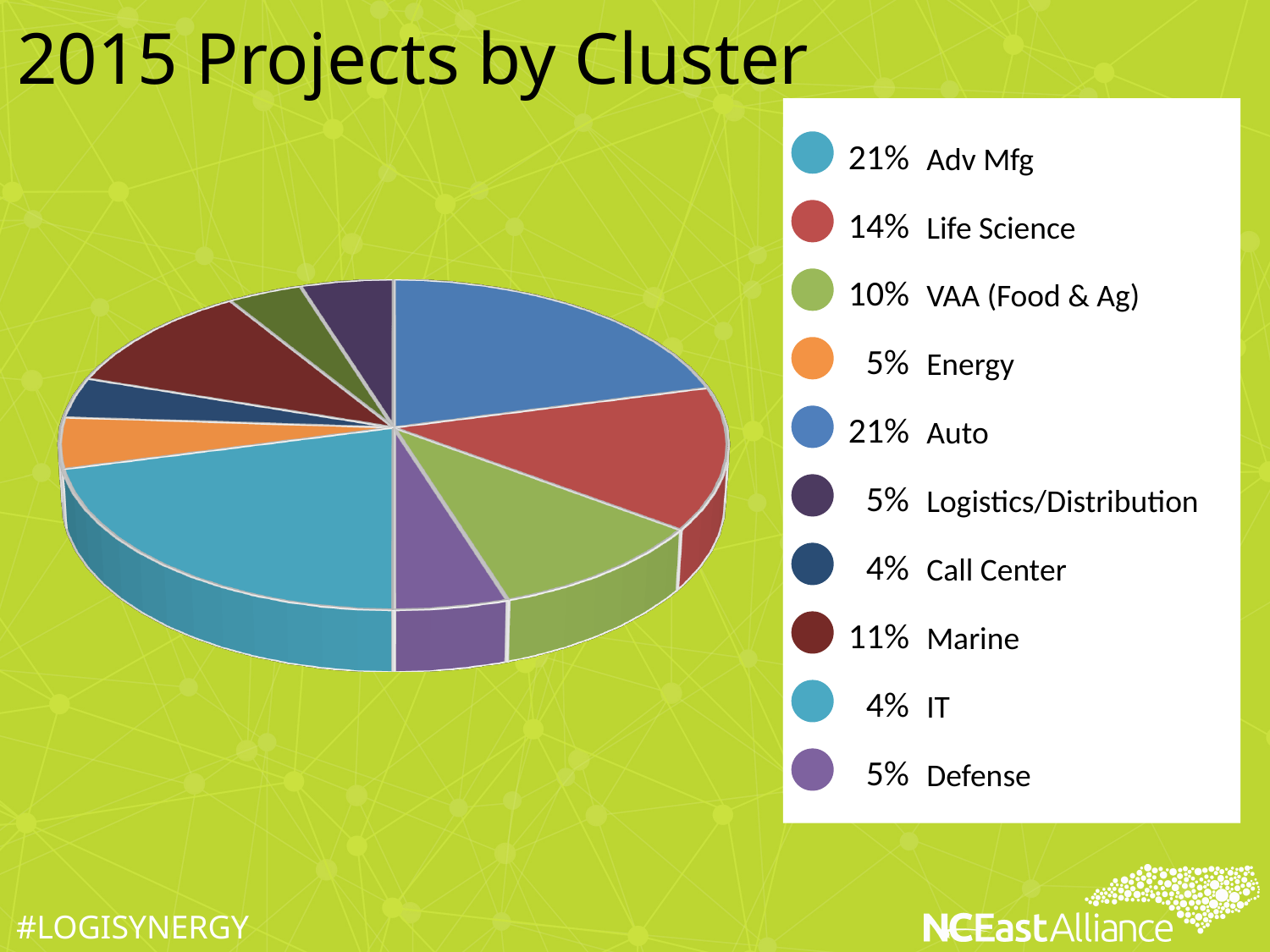
How many clusters are listed in the legend? 10 What share of the pie does Life Science hold? 14% What percentage is shown for Marine? 11% Which is larger, the share for Auto or the share for VAA (Food & Ag)? Auto What kind of chart is shown on the slide? Pie chart What percentage is shown for VAA (Food & Ag)? 10% What is the difference in percentage points between Adv Mfg and Life Science? 7 What is the difference in percentage points between Marine and Energy? 6 Which is larger, the share for Life Science or the share for Marine? Life Science What percentage of 2015 projects is in the Adv Mfg cluster? 21% What percentage is shown for Call Center? 4% What is the title of the chart? 2015 Projects by Cluster